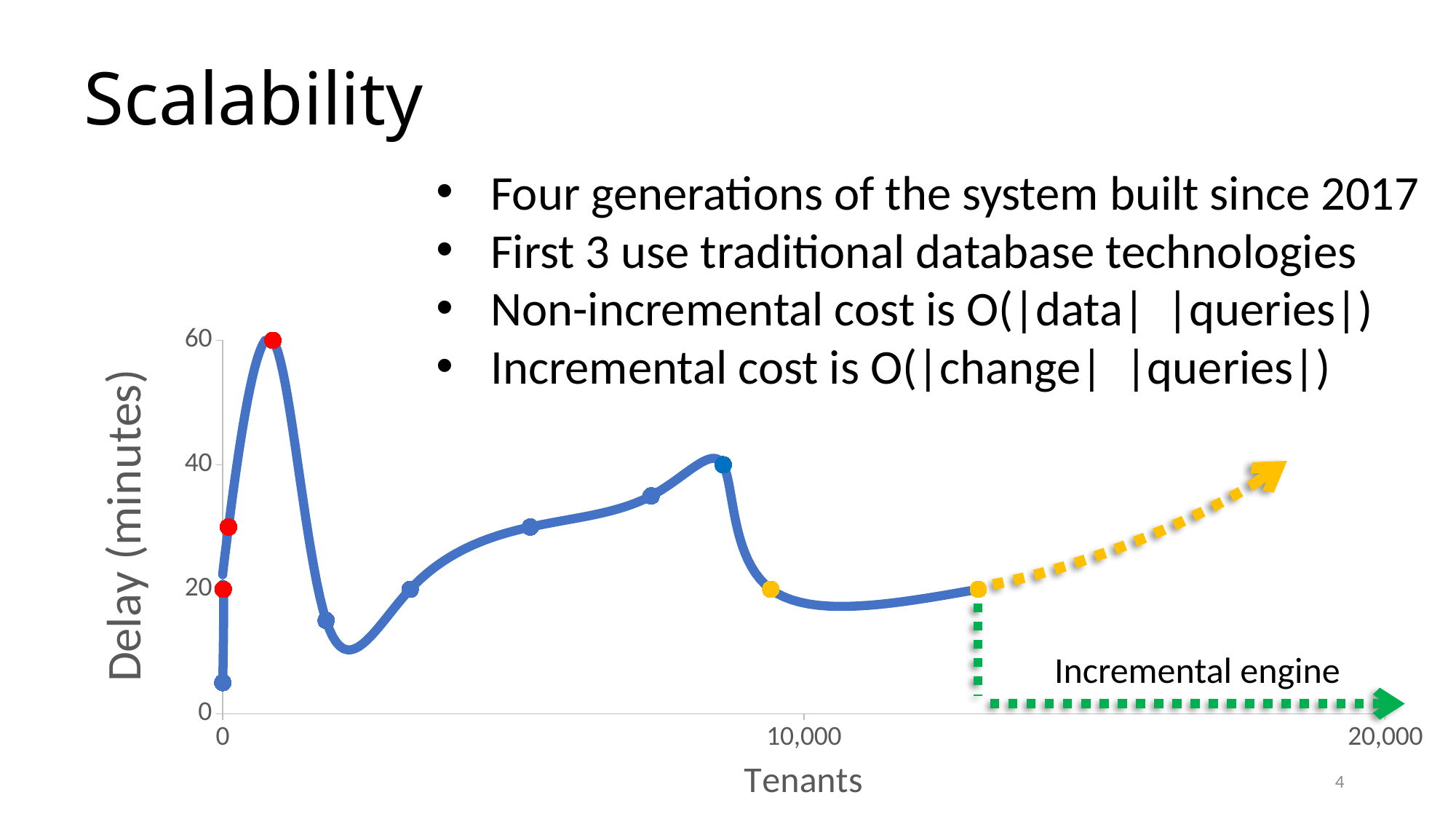
What is the title of the vertical axis of the chart? Delay (minutes) Is the lowest delay value on the curve greater or less than 20? less What is the largest value labelled on the horizontal axis? 20,000 Does the delay rise or fall immediately after the curve reaches its peak of 60? fall Is the peak delay value on the curve greater or less than 40? greater How many labelled tick values are shown on the horizontal axis? 3 What kind of chart is shown on the slide? line chart What is the title of the horizontal axis of the chart? Tenants Is the delay at 10,000 tenants greater or less than 40? less What is the highest delay value reached by the curve? 60